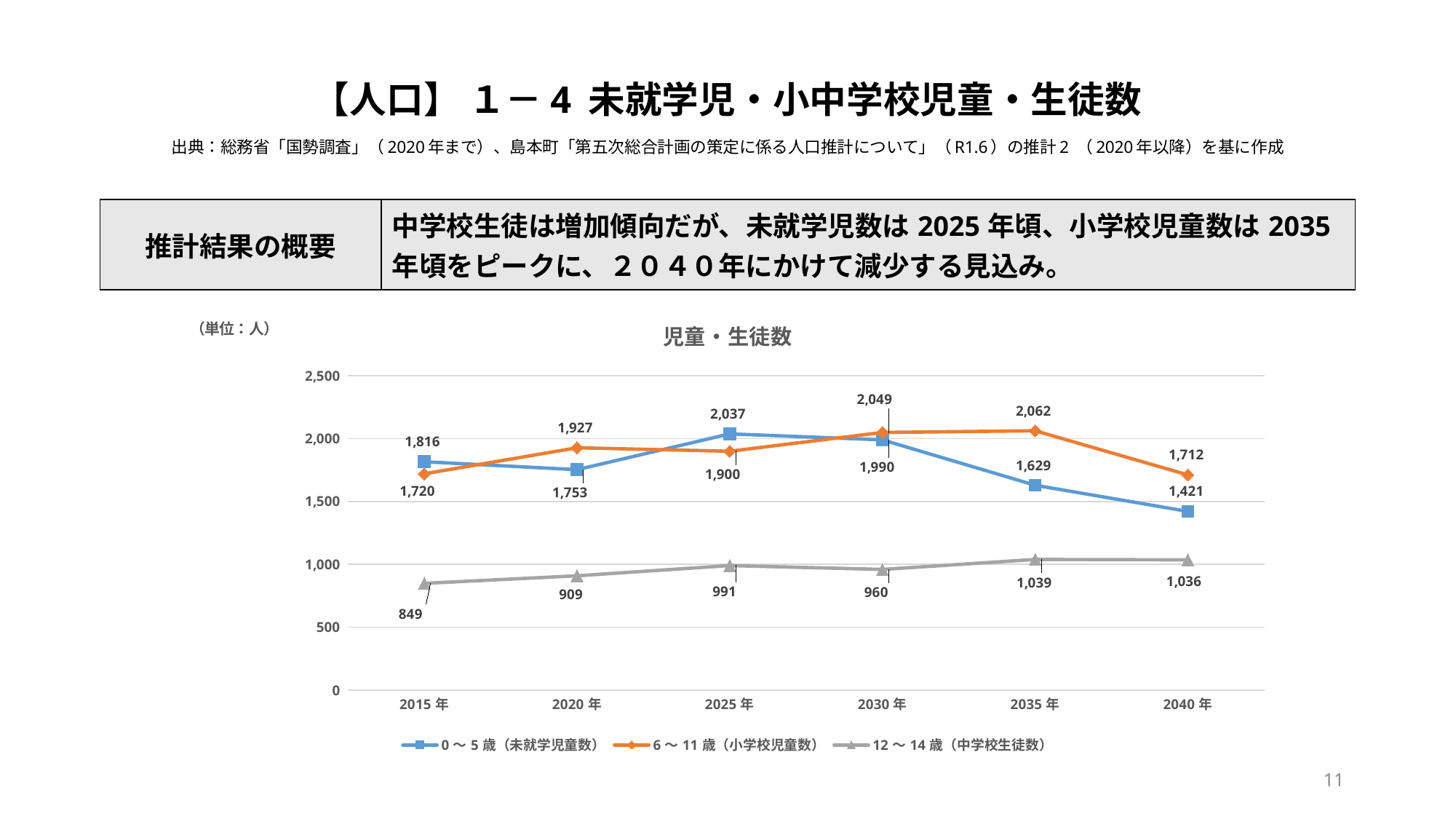
Does the value for 0～5歳（未就学児童数） rise or fall from 2025年 to 2040年? fall In which year is the value for 12～14歳（中学校生徒数） lowest? 2015年 In 2030年, which is larger: 0～5歳（未就学児童数） or 6～11歳（小学校児童数）? 6～11歳（小学校児童数） What type of chart is shown on the slide? line chart What is the difference between the 0～5歳（未就学児童数） values in 2025年 and 2040年? 616 What is the value for 0～5歳（未就学児童数） in 2025年? 2,037 What is the value for 12～14歳（中学校生徒数） in 2015年? 849 How many series does the legend list? 3 What is the title of the chart? 児童・生徒数 How many years are plotted on the x axis? 6 What is the value for 6～11歳（小学校児童数） in 2035年? 2,062 In which year is the value for 0～5歳（未就学児童数） highest? 2025年